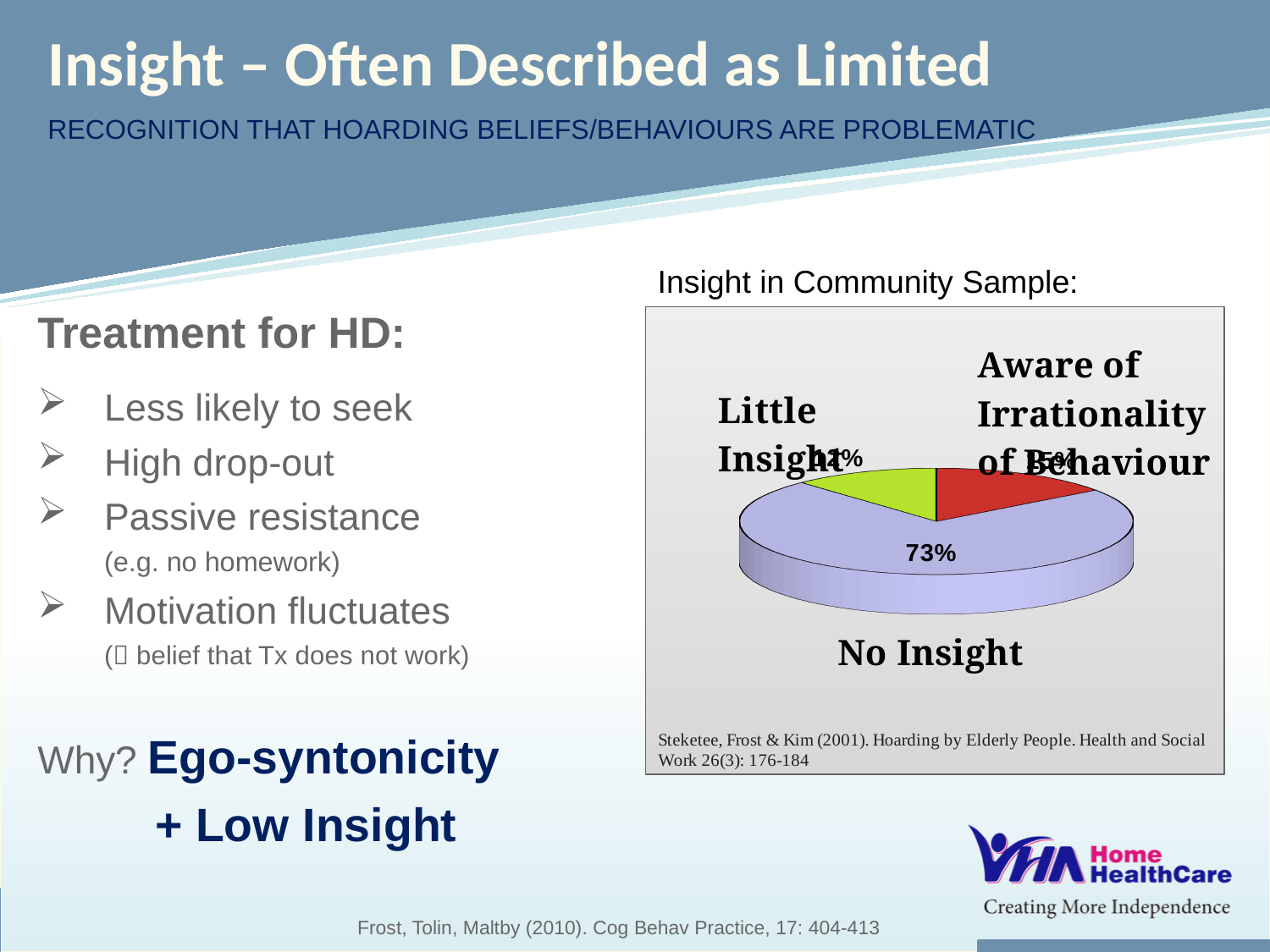
What percentage of the community sample is labelled "No Insight"? 73% What share of the pie does the "No Insight" slice represent? 73% Which slice is larger, "No Insight" or "Little Insight"? No Insight Is the share for "No Insight" greater or less than 50%? greater What colour is the "No Insight" slice of the pie chart? Light purple Which category makes up the largest slice of the pie chart? No Insight What kind of chart is shown on the slide? Pie chart How many slices does the pie chart have? 3 What is the title of the chart on the slide? Insight in Community Sample: Is the share for "Little Insight" greater or less than 50%? less Which slice is larger, "No Insight" or "Aware of Irrationality of Behaviour"? No Insight